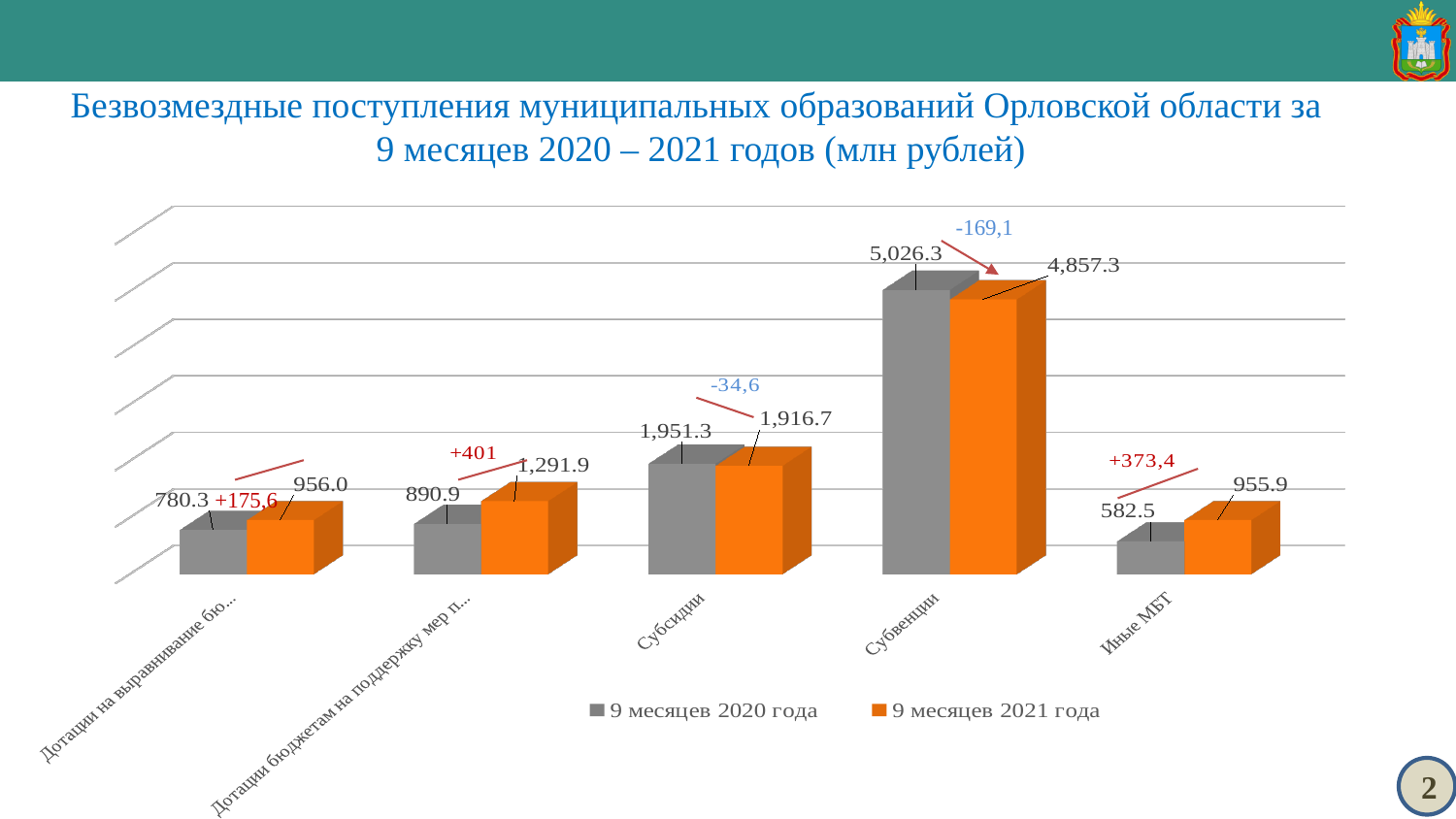
Which category has the highest value for 9 месяцев 2021 года? Субвенции What is the value for Субсидии for 9 месяцев 2021 года? 1,916.7 What is the value for Субвенции for 9 месяцев 2021 года? 4,857.3 How many series does the legend list? 2 What is the difference between the 9 месяцев 2021 года and 9 месяцев 2020 года values for Иные МБТ? 373.4 What kind of chart is shown on the slide? bar chart What is the value for Иные МБТ for 9 месяцев 2020 года? 582.5 For Субсидии, which is larger: the value for 9 месяцев 2020 года or for 9 месяцев 2021 года? 9 месяцев 2020 года Which category has the lowest value for 9 месяцев 2020 года? Иные МБТ How many categories are shown on the x axis? 5 What change is annotated above the Субвенции bars? -169,1 What is the value for Субвенции for 9 месяцев 2020 года? 5,026.3